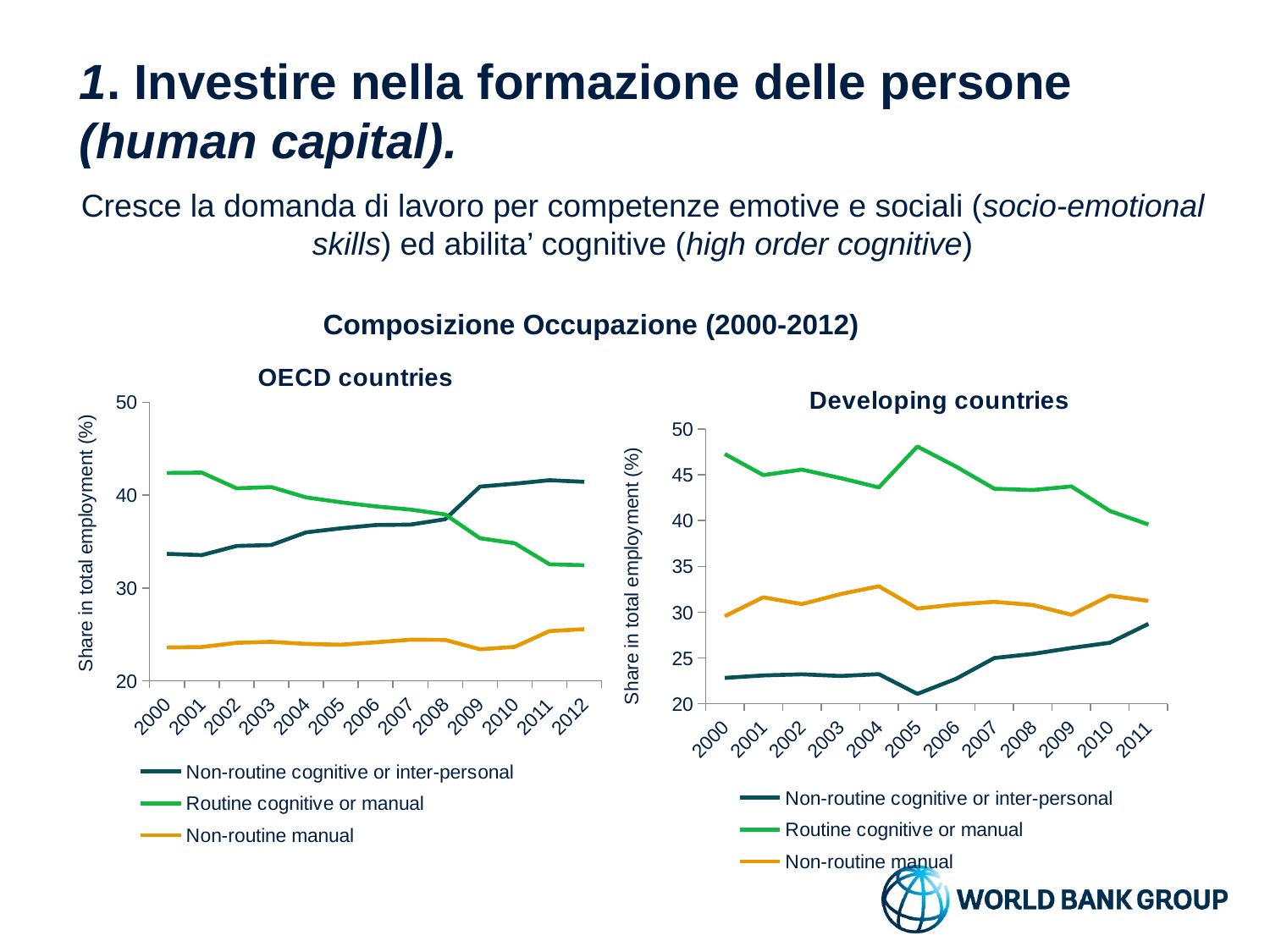
In the OECD countries chart, which is larger in 2012: Non-routine cognitive or inter-personal or Routine cognitive or manual? Non-routine cognitive or inter-personal What is the overall title shown above the two charts? Composizione Occupazione (2000-2012) How many years are plotted on the x axis of the OECD countries chart? 13 In the Developing countries chart, is the value for Non-routine cognitive or inter-personal in 2005 greater or less than 25? less In the OECD countries chart, does the Non-routine cognitive or inter-personal series rise or fall from 2000 to 2012? rise In the OECD countries chart, does the Routine cognitive or manual series rise or fall from 2000 to 2012? fall In the Developing countries chart, which series has the highest value in 2000? Routine cognitive or manual What kind of chart is the OECD countries chart? line chart How many years are plotted on the x axis of the Developing countries chart? 12 In the Developing countries chart, is the value for Routine cognitive or manual in 2005 greater or less than 45? greater How many series does the legend of the OECD countries chart list? 3 In the OECD countries chart, is the value for Non-routine manual in 2000 greater or less than 30? less